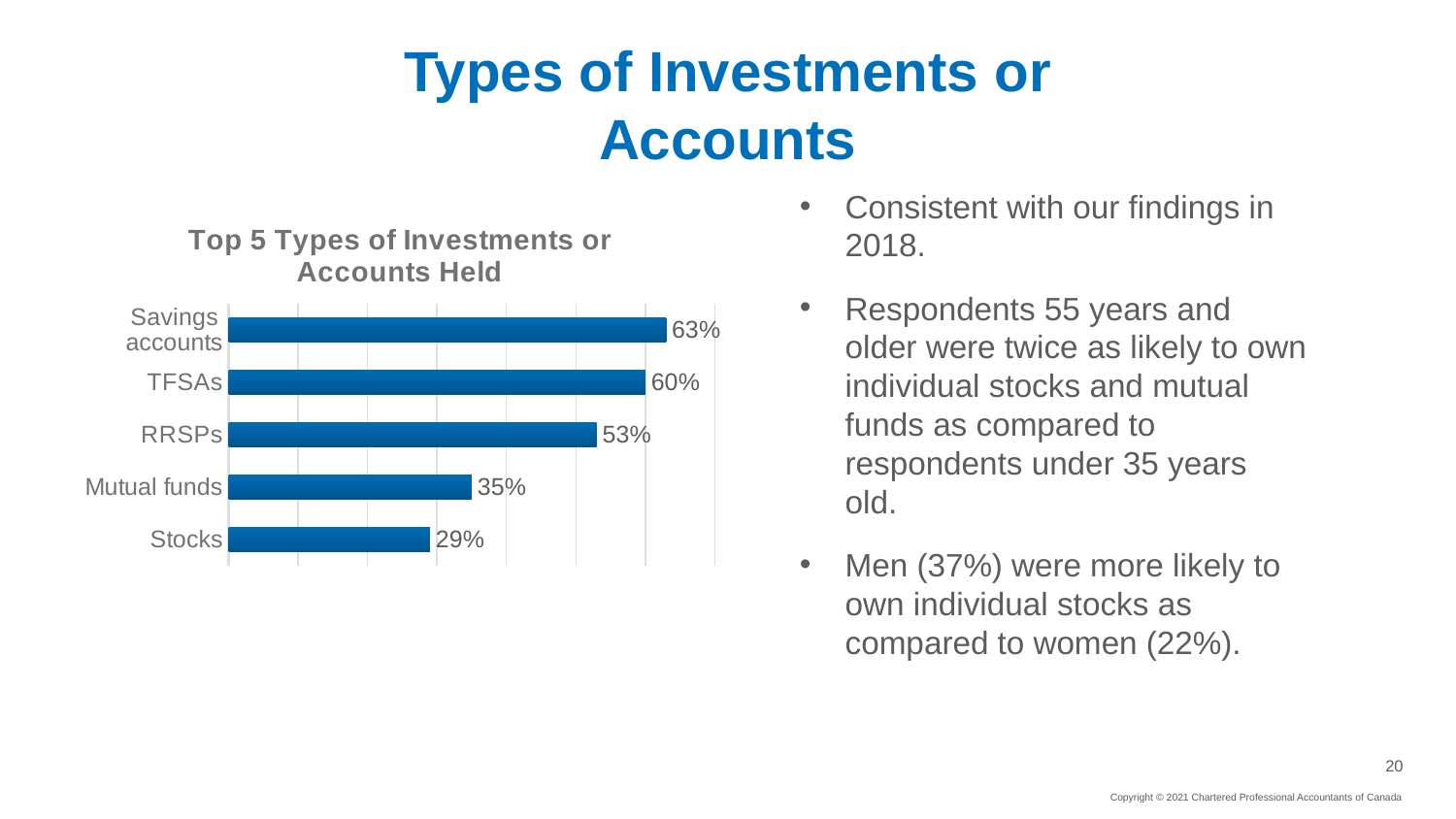
What percentage of respondents hold savings accounts? 63% Which is larger, the value for TFSAs or the value for RRSPs? TFSAs Which type of investment or account has the lowest value? Stocks What is the value shown for TFSAs? 60% Which type of investment or account has the highest value? Savings accounts What is the value for Mutual funds? 35% What is the difference between the values for Savings accounts and Stocks? 34% What kind of chart is shown on the slide? Bar chart What is the difference between the values for RRSPs and Mutual funds? 18% What is the title of the chart? Top 5 Types of Investments or Accounts Held What percentage is shown for RRSPs? 53% How many types of investments or accounts are shown in the chart? 5